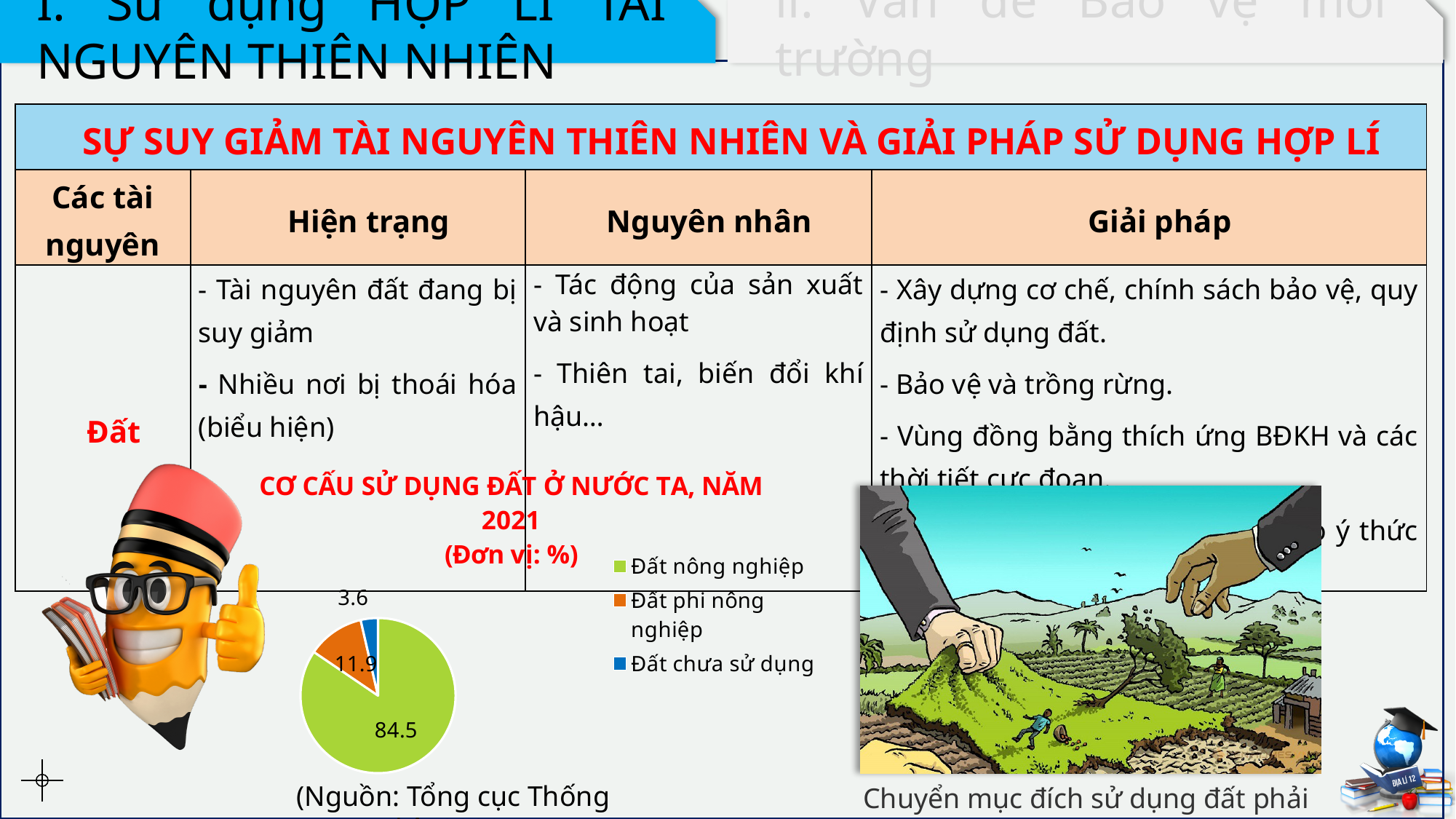
What is the value for Đất nông nghiệp in the pie chart? 84.5 What type of chart is shown on the slide? pie chart What unit is stated for the pie chart's values? % What is the difference between the values for Đất nông nghiệp and Đất phi nông nghiệp? 72.6 What is the value for Đất phi nông nghiệp in the pie chart? 11.9 What is the value for Đất chưa sử dụng in the pie chart? 3.6 What is the difference between the values for Đất phi nông nghiệp and Đất chưa sử dụng? 8.3 How many categories does the pie chart show? 3 Which is larger, Đất phi nông nghiệp or Đất chưa sử dụng? Đất phi nông nghiệp What year does the pie chart's title refer to? 2021 Which category has the smallest slice in the pie chart? Đất chưa sử dụng Which category has the largest slice in the pie chart? Đất nông nghiệp